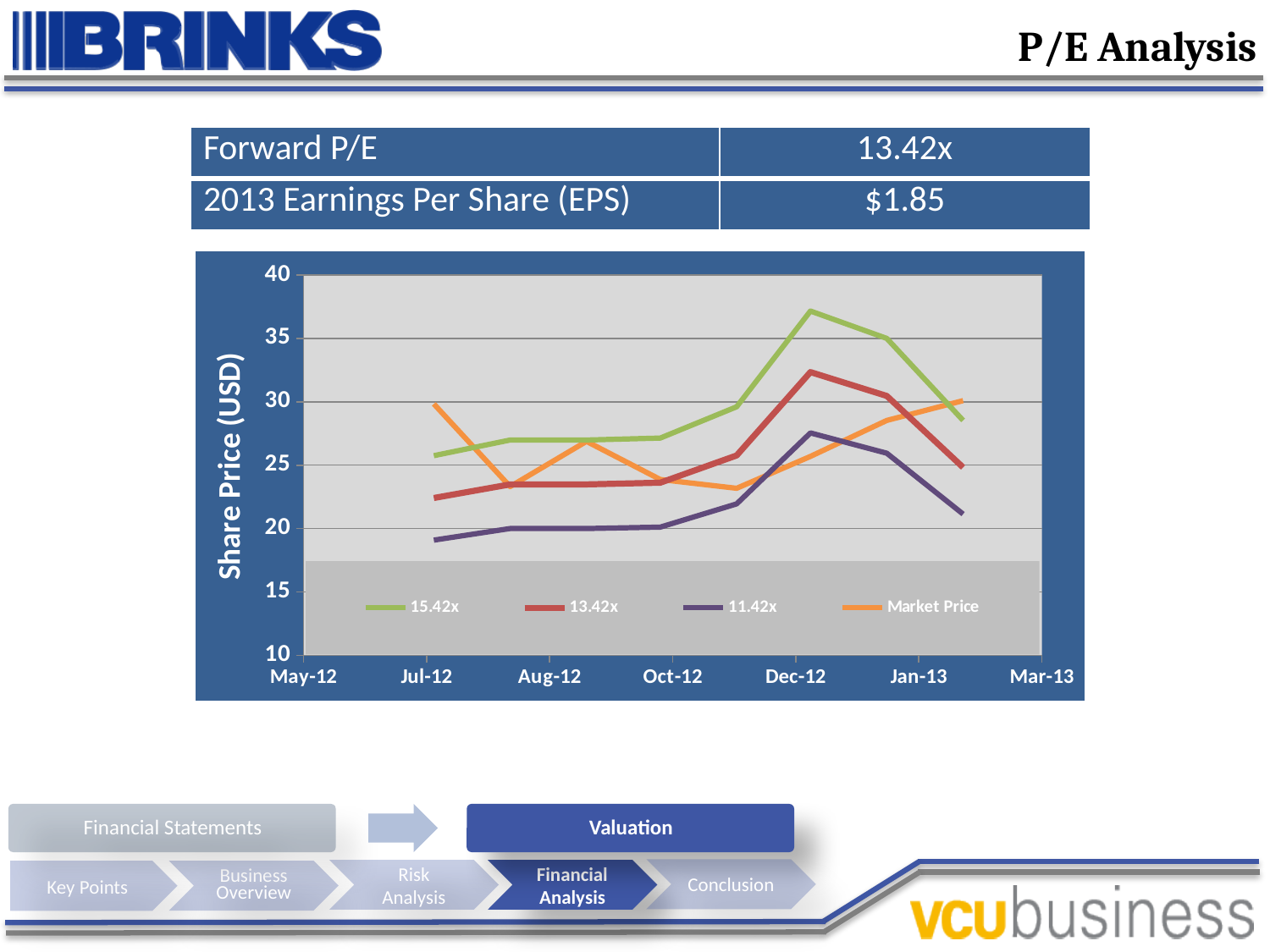
Is the value of the 11.42x series at Jul-12 greater or less than 20? less Which series has the highest value at Dec-12? 15.42x How many series does the chart legend list? 4 Is the value of the 13.42x series at Dec-12 greater or less than 30? greater Is the Market Price at Jul-12 greater or less than 25? greater What is the title of the vertical axis of the chart? Share Price (USD) Which series is represented by the orange line in the chart? Market Price Which series has the lowest value at Jul-12? 11.42x What kind of chart is shown on the slide? line chart At Jul-12, which is higher: the Market Price or the 15.42x series? Market Price How many date labels are shown along the x axis of the chart? 7